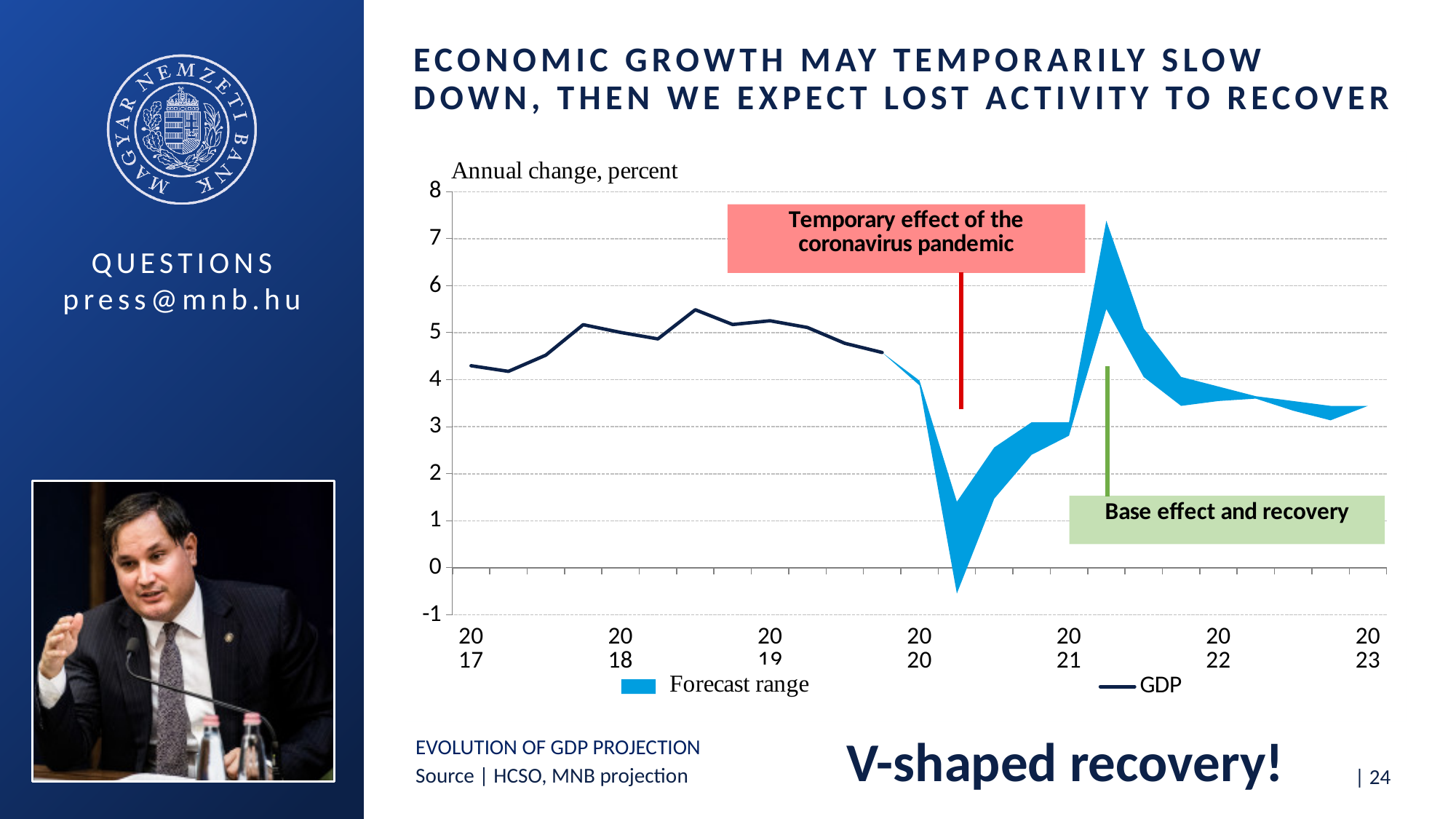
Does the forecast range rise or fall from its low point in 2020 to its peak in 2021? rise Is the highest point of the GDP line in 2018 greater or less than 5? greater Does the GDP line rise or fall between the start of 2019 and the start of 2020? fall Which year on the x axis contains the lowest point of the forecast range? 2020 Is the GDP value at the start of 2017 greater or less than 4? greater What are the two entries in the chart legend? Forecast range and GDP What is the unit label shown above the chart's vertical axis? Annual change, percent Is the upper edge of the forecast range at its 2021 peak greater or less than 7? greater How many series does the chart legend list? 2 What kind of chart is shown on the slide? line chart